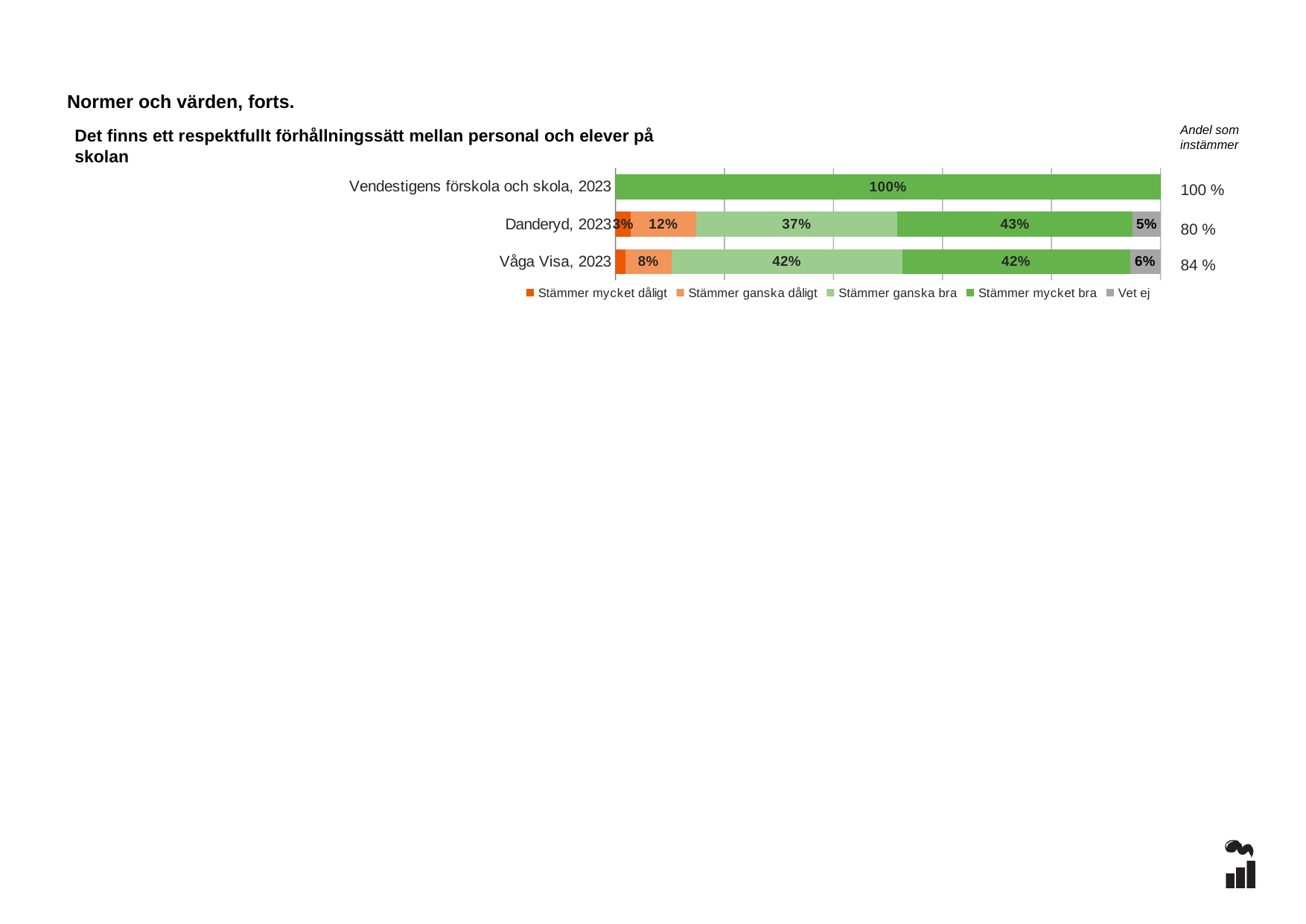
Which is larger: the 'Stämmer ganska dåligt' value for Danderyd, 2023 or for Våga Visa, 2023? Danderyd, 2023 What is the 'Vet ej' value for Våga Visa, 2023? 6% What is the 'Stämmer mycket bra' value for Vendestigens förskola och skola, 2023? 100% What is the difference between the 'Stämmer ganska bra' values for Våga Visa, 2023 and Danderyd, 2023? 5% Which category has the highest 'Andel som instämmer'? Vendestigens förskola och skola, 2023 What is the 'Stämmer mycket bra' value for Danderyd, 2023? 43% What is the 'Andel som instämmer' value shown for Danderyd, 2023? 80 % What is the 'Stämmer ganska dåligt' value for Våga Visa, 2023? 8% How many series does the legend list? 5 What is the 'Stämmer ganska bra' value for Danderyd, 2023? 37% How many categories (rows) does the chart show? 3 What kind of chart is shown on the slide? Stacked bar chart